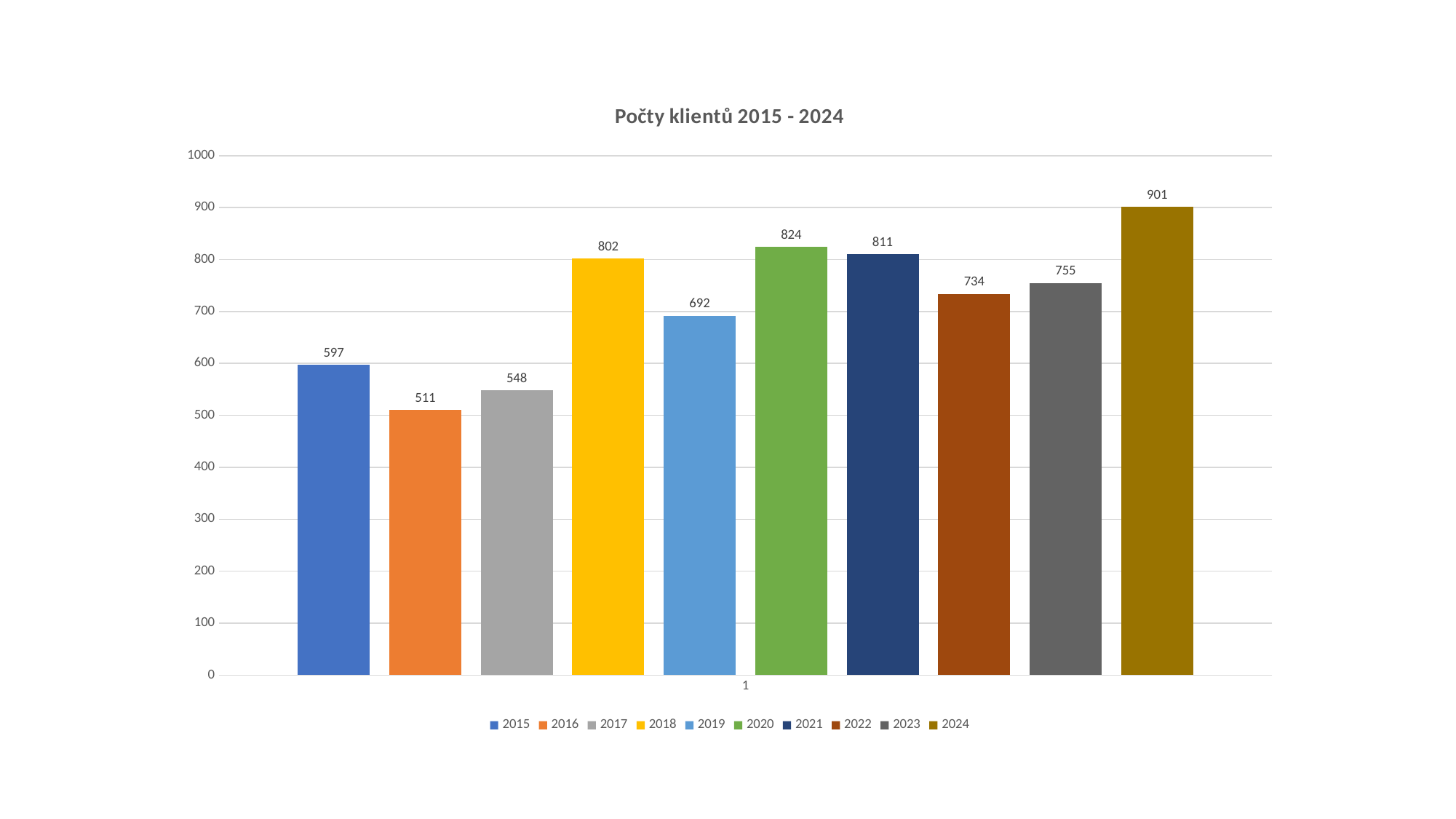
What is the value for 2018? 802 What is the difference between the values for 2020 and 2019? 132 Which is larger, the value for 2021 or the value for 2023? 2021 What kind of chart is shown? bar chart What is the value for 2022? 734 What is the title of the chart? Počty klientů 2015 - 2024 How many series does the legend list? 10 What is the difference between the values for 2024 and 2015? 304 Which year has the lowest value? 2016 What colour is the bar for 2020? green Which year has the highest value? 2024 Is the value for 2017 greater or less than 600? less